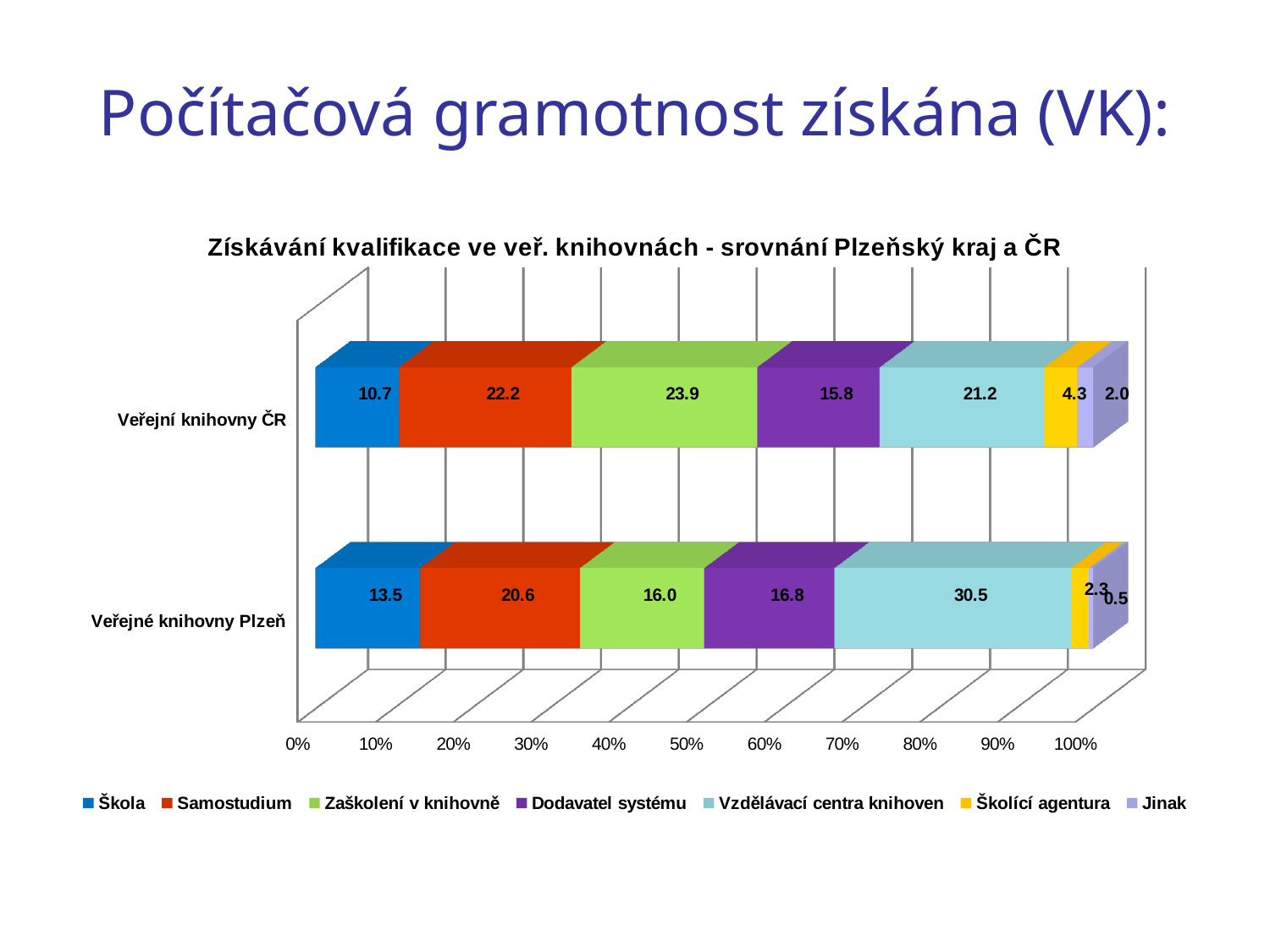
How many series does the legend list? 7 What is the difference between the Vzdělávací centra knihoven values for Veřejné knihovny Plzeň and Veřejní knihovny ČR? 9.3 What is the value for Jinak for Veřejní knihovny ČR? 2.0 Which series has the smallest value for Veřejní knihovny ČR? Jinak Which series has the largest value for Veřejné knihovny Plzeň? Vzdělávací centra knihoven What is the value for Samostudium for Veřejné knihovny Plzeň? 20.6 How many categories (bars) does the chart show? 2 What is the value for Škola for Veřejní knihovny ČR? 10.7 Which is larger: the Zaškolení v knihovně value for Veřejní knihovny ČR or for Veřejné knihovny Plzeň? Veřejní knihovny ČR What is the title of the chart? Získávání kvalifikace ve veř. knihovnách - srovnání Plzeňský kraj a ČR What is the value for Vzdělávací centra knihoven for Veřejné knihovny Plzeň? 30.5 What kind of chart is shown on the slide? Stacked bar chart